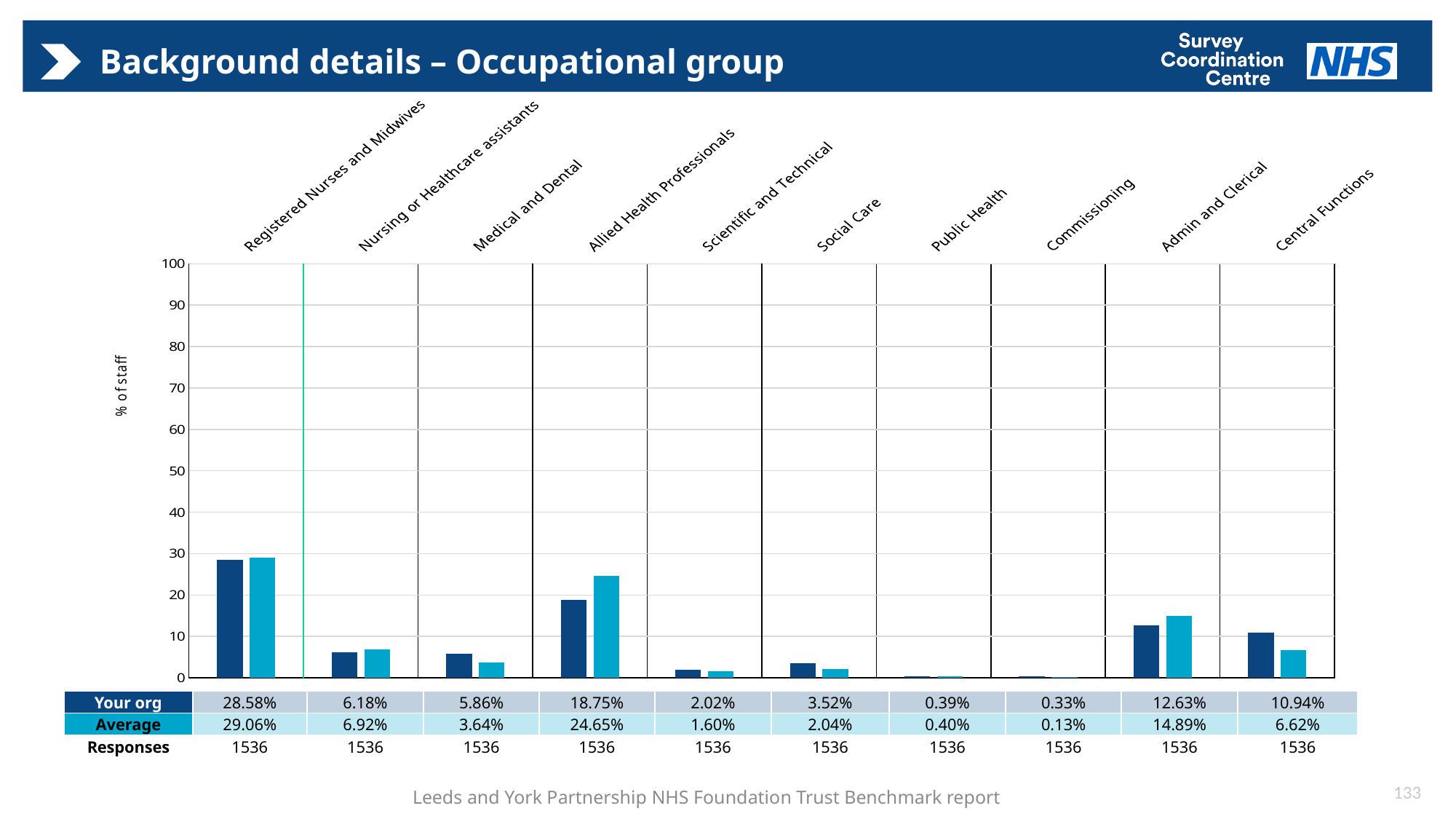
What is the 'Your org' value for Central Functions? 10.94% What is the 'Your org' value for Allied Health Professionals? 18.75% What is the Average value for Admin and Clerical? 14.89% Is the 'Your org' value for Registered Nurses and Midwives greater or less than 20? greater Which occupational group has the highest 'Your org' value? Registered Nurses and Midwives What is the difference between the Average and 'Your org' values for Allied Health Professionals? 5.90% Which occupational group has the lowest Average value? Commissioning For Medical and Dental, which is larger: the 'Your org' value or the Average value? Your org What is the number of responses for Social Care? 1536 What kind of chart is shown on the slide? Bar chart How many occupational groups are shown on the chart? 10 How many series does the chart show? 2